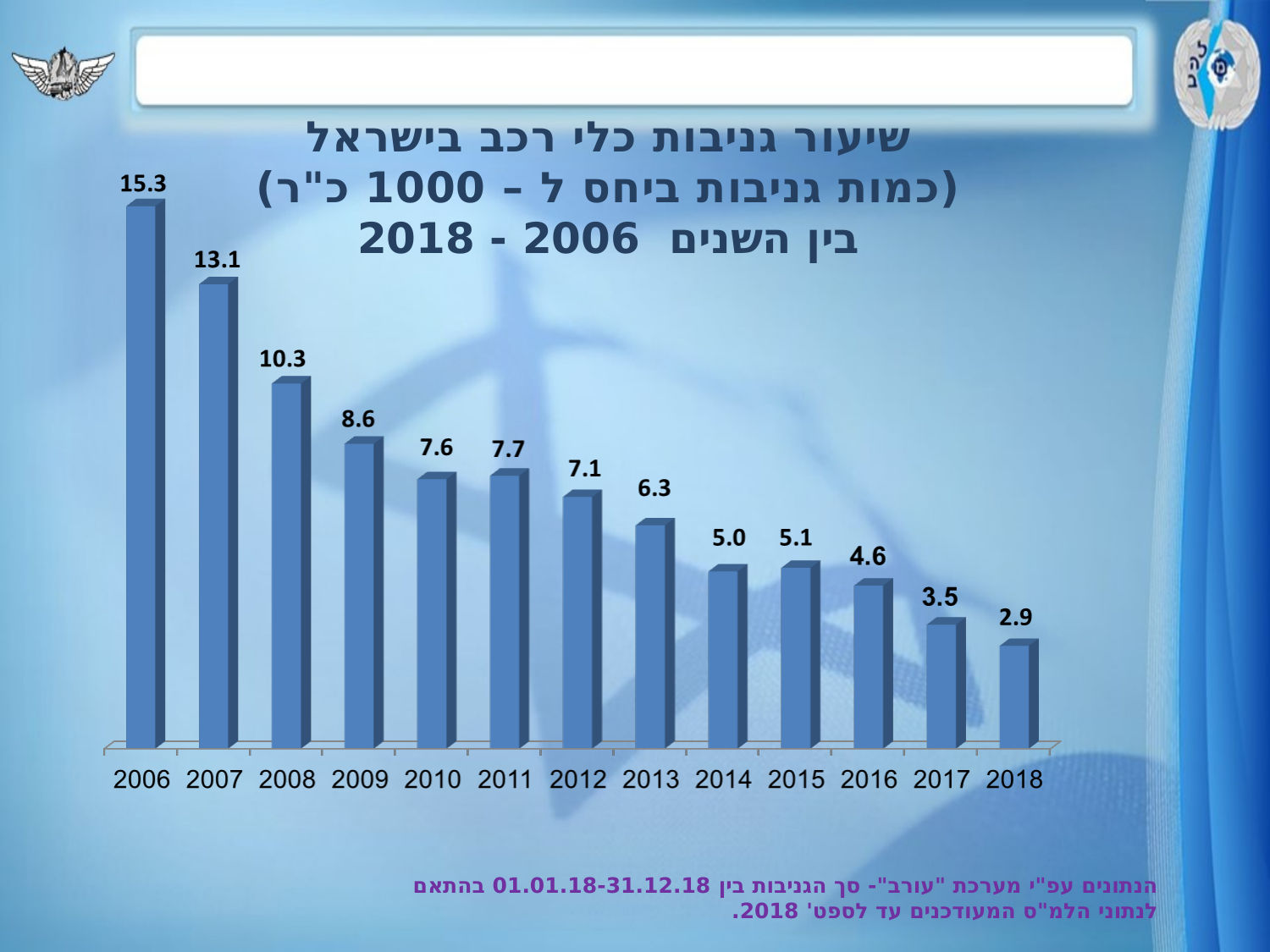
What is the difference between the values for 2006 and 2018? 12.4 Do the values generally rise or fall from 2006 to 2018? Fall What is the value shown for 2012? 7.1 Which year has the highest value? 2006 What is the difference between the values for 2010 and 2011? 0.1 How many years are shown on the x axis? 13 Which year has the lowest value? 2018 Which is larger, the value for 2009 or the value for 2013? 2009 What is the value shown for 2006? 15.3 What range of years does the chart title say it covers? 2006 - 2018 What is the value shown for 2018? 2.9 What kind of chart is shown on the slide? Bar chart